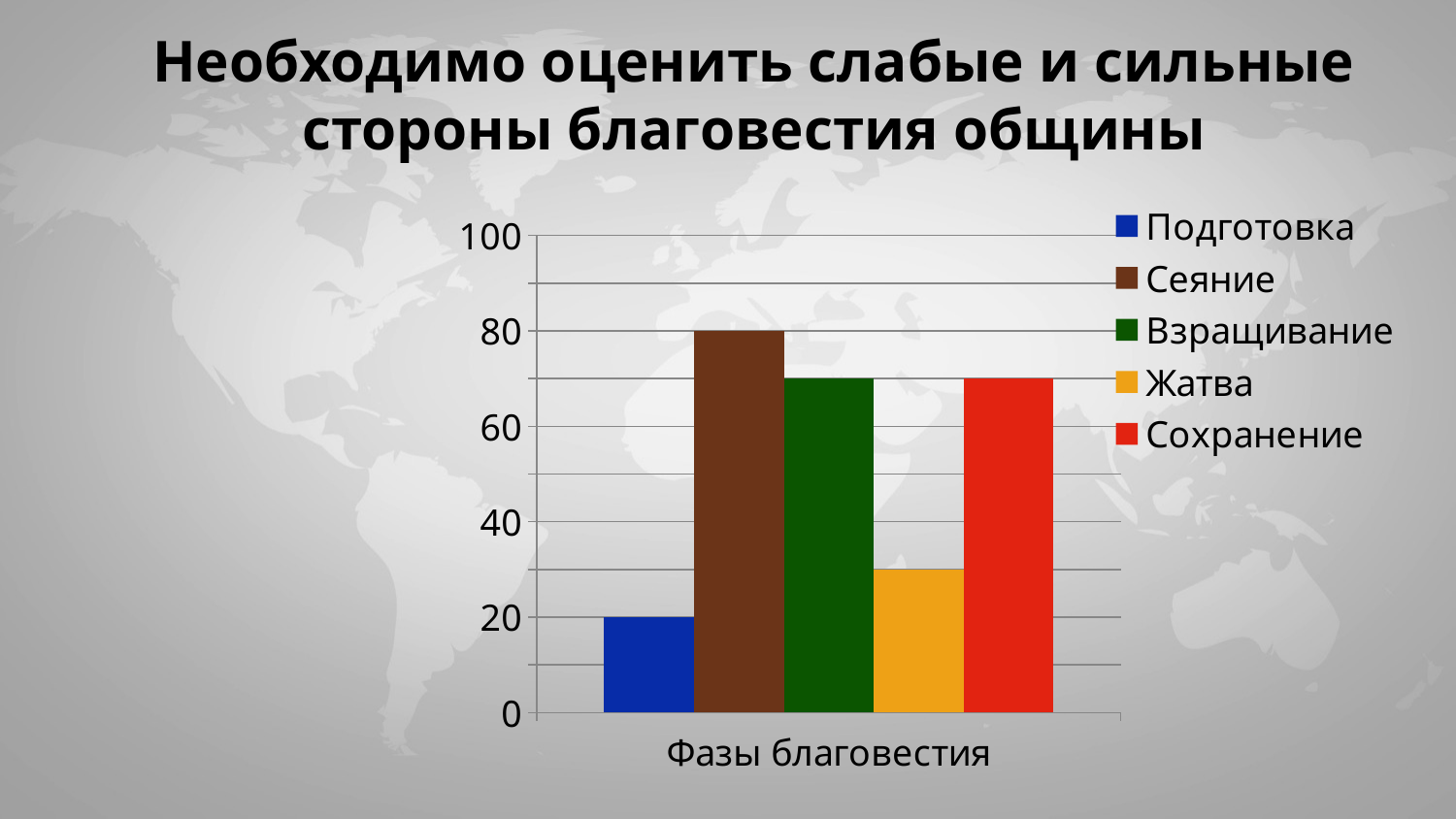
What kind of chart is shown on the slide? bar chart Is the value for Жатва greater or less than 40? less What is the label on the x axis of the chart? Фазы благовестия What is the value for Сеяние? 80 How many series does the legend list? 5 What is the value for Подготовка? 20 Is the value for Взращивание greater or less than 60? greater Which series has the lowest bar? Подготовка Which series has the highest bar? Сеяние Is the value for Сохранение greater or less than 80? less Which is larger, the value for Сеяние or the value for Жатва? Сеяние What is the difference between the values for Сеяние and Подготовка? 60